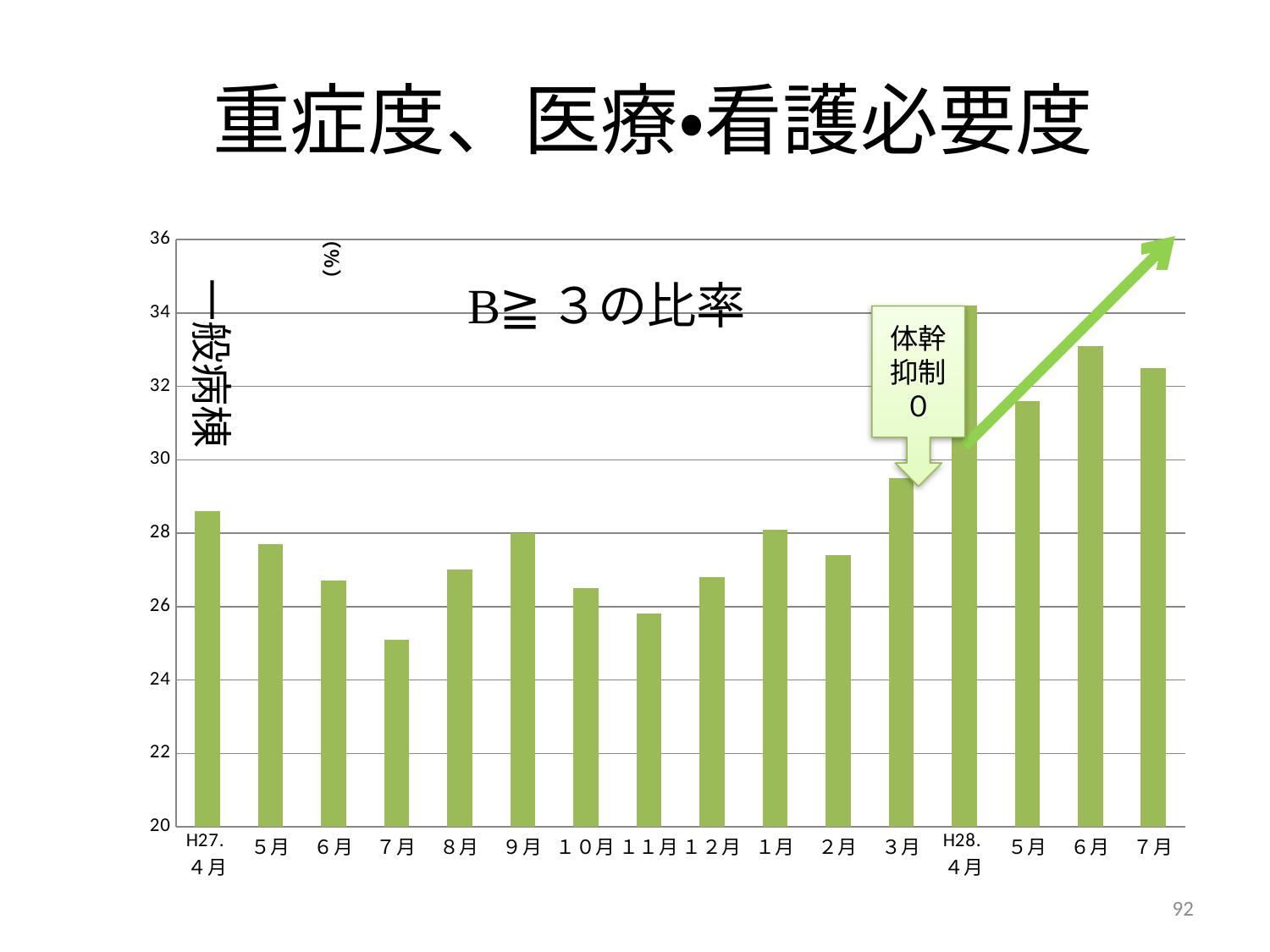
Which month has the lowest value in the chart? 7月 (H27) Which month has the highest value in the chart? H28. 4月 What is the title shown inside the chart area? B≧３の比率 What text is in the callout box pointing at the 3月 bar? 体幹抑制０ Is the value for 6月 (H28) greater or less than 32? greater Do the values rise or fall from 3月 to H28. 4月? rise Is the value for H27. 4月 greater or less than 28? greater Is the value for 3月 greater or less than 30? less Which is larger, the value for 5月 (H28) or the value for 7月 (H28)? 7月 (H28) How many bars (months) are plotted in the chart? 16 What kind of chart is shown on the slide? bar chart